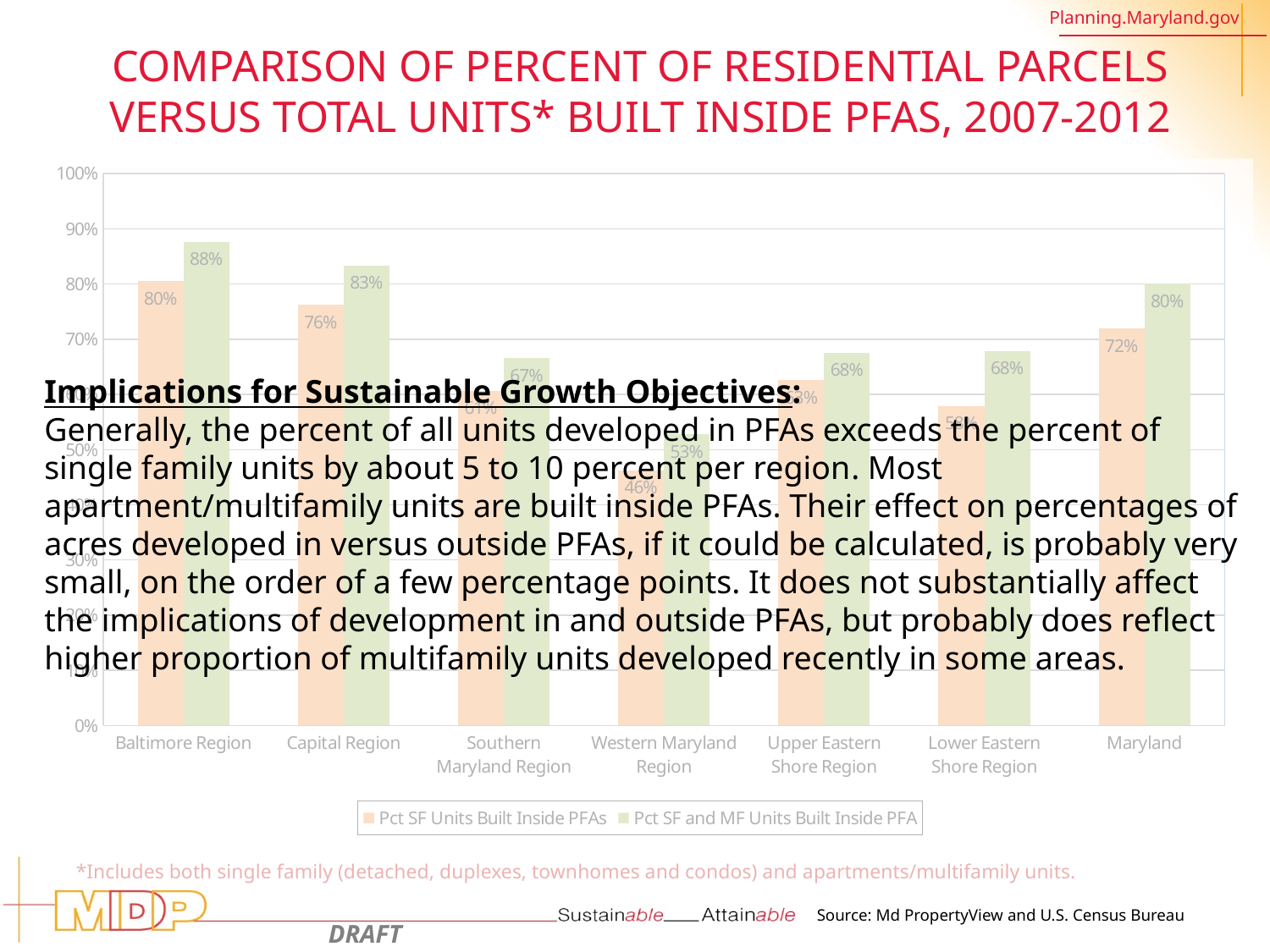
How many series does the legend list? 2 Which region has the lowest value for Pct SF Units Built Inside PFAs? Western Maryland Region Which is larger for Pct SF Units Built Inside PFAs: the Capital Region or Maryland? Capital Region Which region has the highest value for Pct SF and MF Units Built Inside PFA? Baltimore Region Is the value for Pct SF Units Built Inside PFAs in the Western Maryland Region greater or less than 50%? less What is the value for Pct SF Units Built Inside PFAs in the Capital Region? 76% What is the value for Pct SF Units Built Inside PFAs in the Baltimore Region? 80% How many regions are shown on the x axis of the chart? 7 What is the value for Pct SF and MF Units Built Inside PFA in the Baltimore Region? 88% What is the value for Pct SF and MF Units Built Inside PFA for Maryland? 80% In the Baltimore Region, what is the difference between Pct SF and MF Units Built Inside PFA and Pct SF Units Built Inside PFAs? 8 percentage points What kind of chart is shown on the slide? bar chart